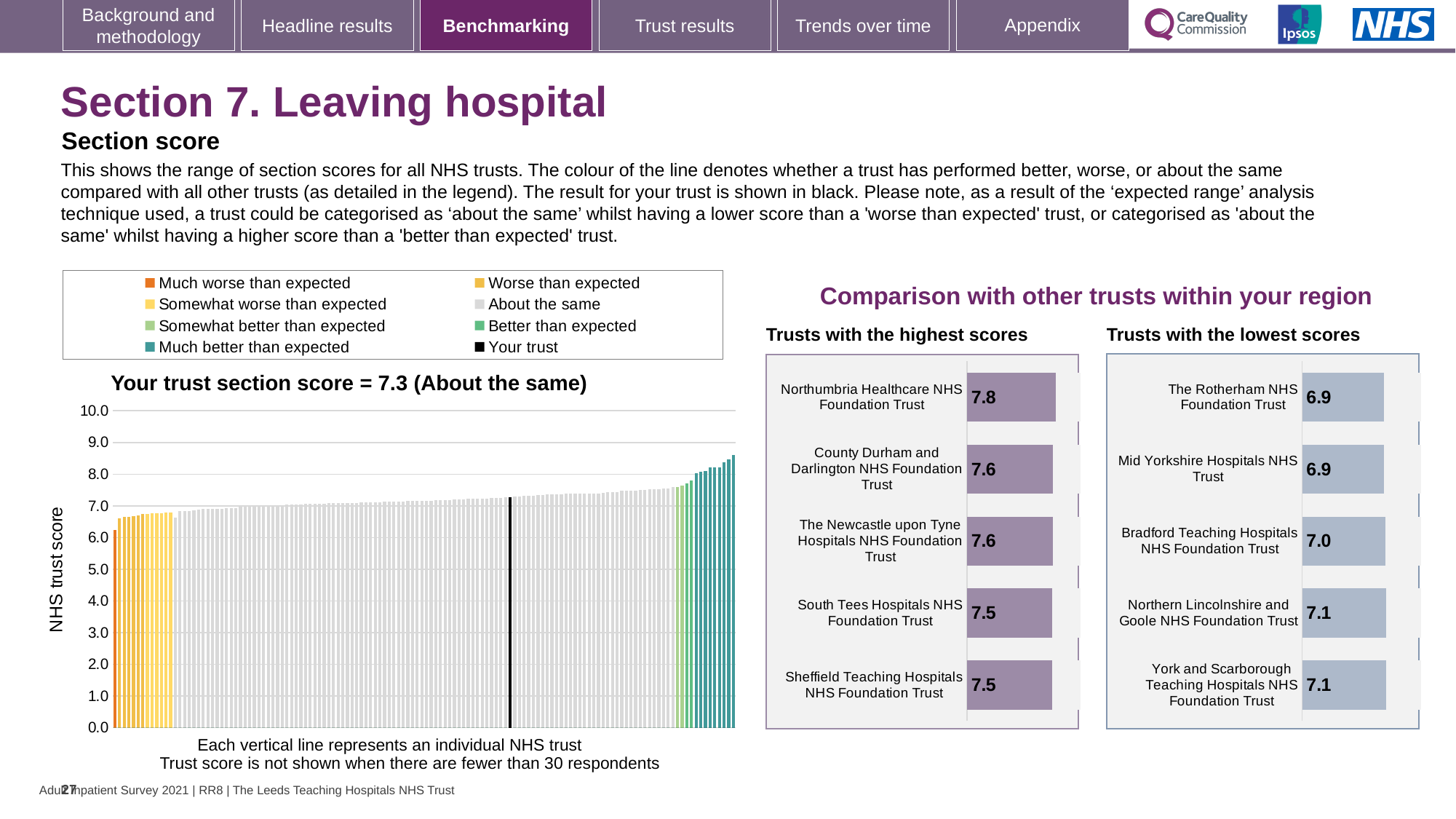
In the 'Trusts with the lowest scores' chart, what is the score for Bradford Teaching Hospitals NHS Foundation Trust? 7.0 In the 'Your trust section score' chart, what is the section score for your trust? 7.3 In the 'Your trust section score' chart, how many entries does the legend list? 8 In the 'Trusts with the lowest scores' chart, how many trusts are shown? 5 In the 'Your trust section score' chart, what kind of chart is shown? bar chart In the 'Trusts with the highest scores' chart, which trust has the highest score? Northumbria Healthcare NHS Foundation Trust In the 'Your trust section score' chart, is the value for the lowest-scoring trust greater or less than 7.0? less In the 'Trusts with the lowest scores' chart, which has the higher score: The Rotherham NHS Foundation Trust or York and Scarborough Teaching Hospitals NHS Foundation Trust? York and Scarborough Teaching Hospitals NHS Foundation Trust In the 'Your trust section score' chart, what is the label on the vertical axis? NHS trust score In the 'Trusts with the highest scores' chart, what is the difference between the scores of Northumbria Healthcare NHS Foundation Trust and Sheffield Teaching Hospitals NHS Foundation Trust? 0.3 In the 'Trusts with the highest scores' chart, what is the score for South Tees Hospitals NHS Foundation Trust? 7.5 In the 'Your trust section score' chart, is the value for the highest-scoring trust greater or less than 8.0? greater